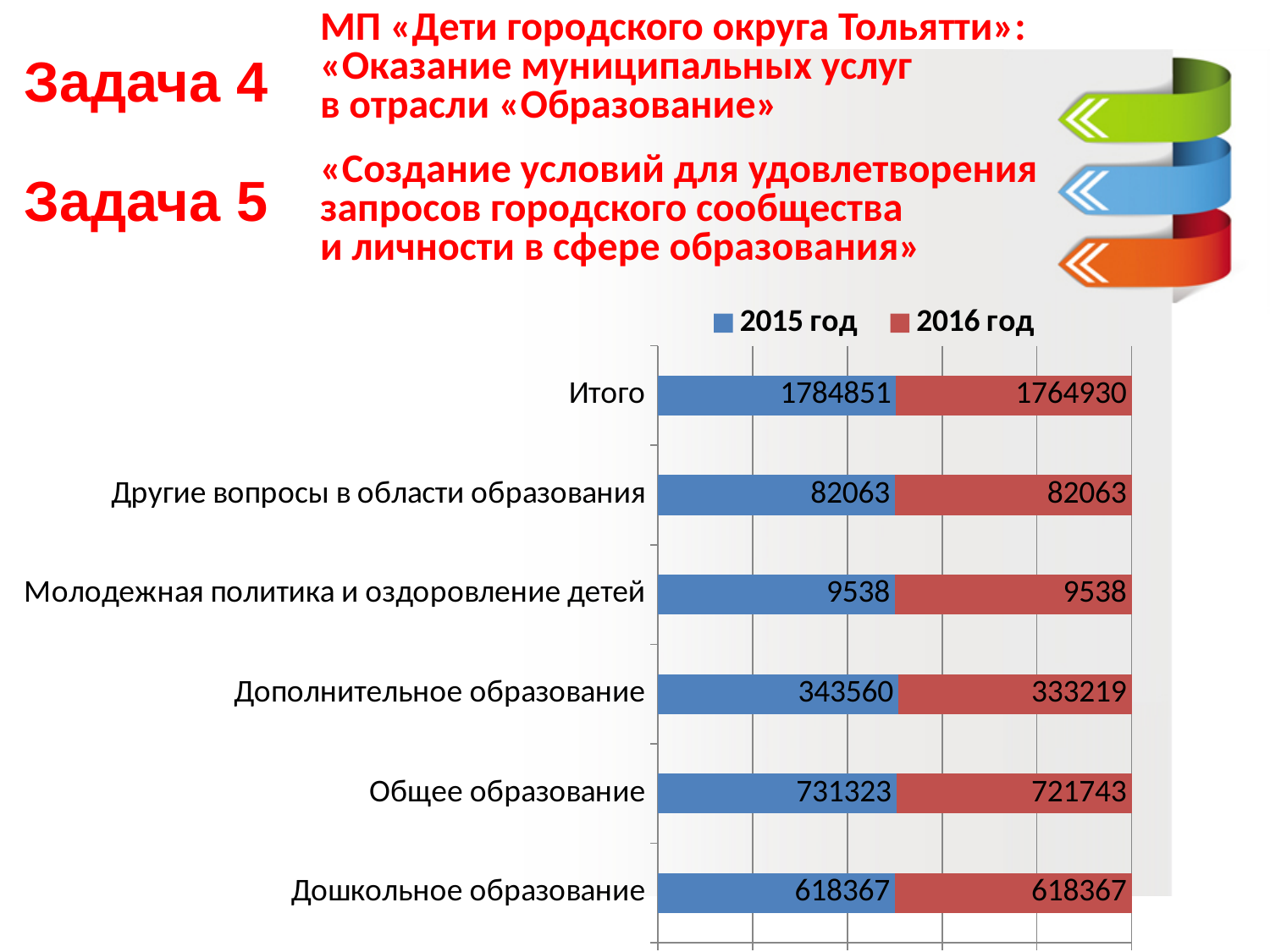
What kind of chart is shown on the slide? Bar chart Excluding Итого, which category has the lowest 2016 год value according to the data labels? Молодежная политика и оздоровление детей What is the value for Дополнительное образование in the 2016 год series? 333219 What is the value for Общее образование in the 2015 год series? 731323 Which is larger for Дополнительное образование: the 2015 год value or the 2016 год value? 2015 год Excluding Итого, which category has the highest 2015 год value according to the data labels? Общее образование What is the 2016 год value for Молодежная политика и оздоровление детей? 9538 How many series does the legend list? 2 What is the difference between the 2015 год and 2016 год values for Итого? 19921 What is the difference between the 2015 год and 2016 год values for Общее образование? 9580 What is the 2015 год value for Итого? 1784851 How many categories are shown on the chart? 6